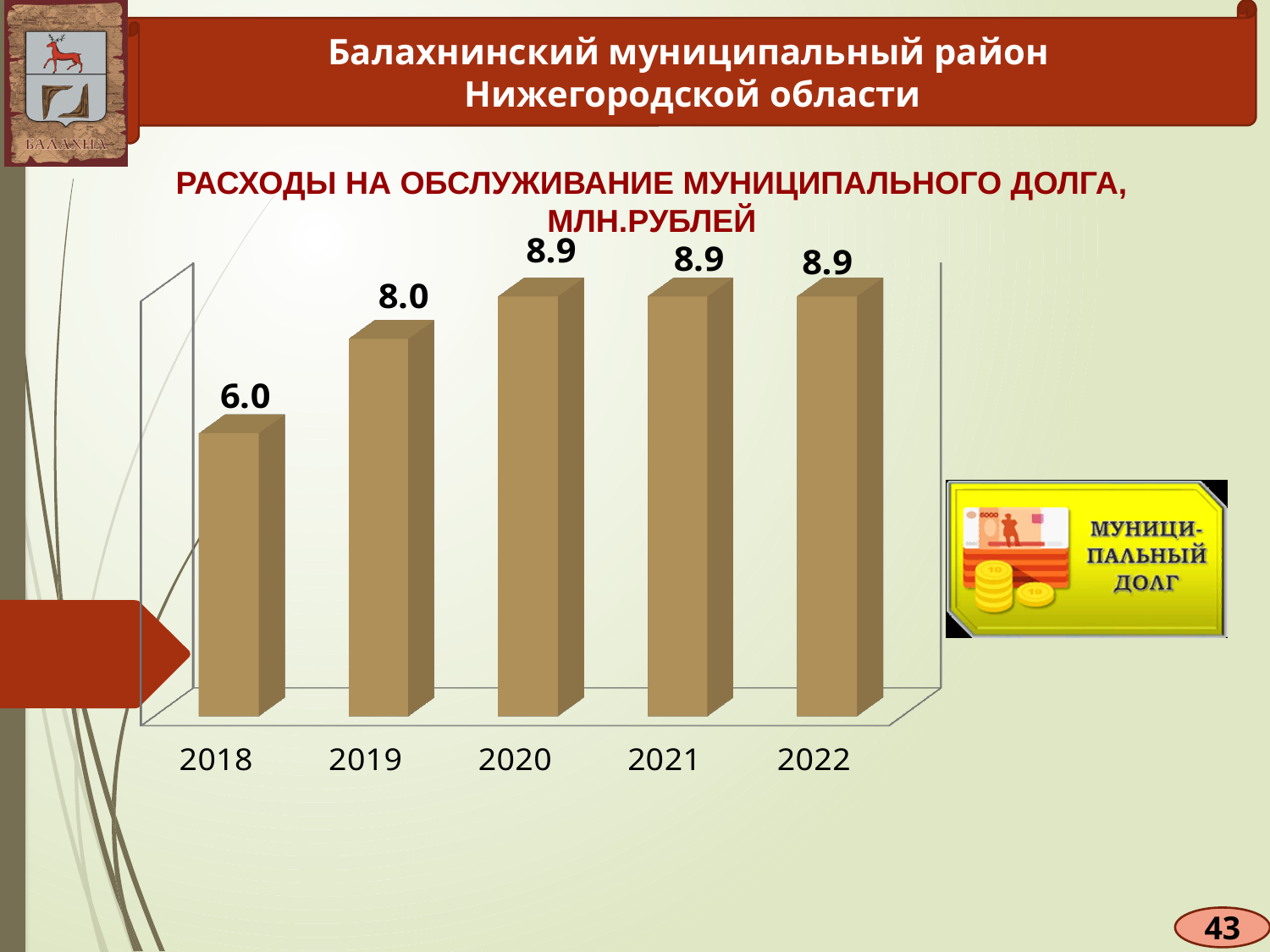
Which year has the lowest value? 2018 What is the value for 2019? 8.0 Which is larger, the value for 2019 or the value for 2021? 2021 What is the difference between the values for 2020 and 2019? 0.9 What kind of chart is shown on the slide? bar chart What unit is stated in the chart title? млн.рублей What is the value for 2018? 6.0 What is the value for 2022? 8.9 Do the values rise or fall from 2018 to 2020? rise How many years are shown on the chart? 5 What is the difference between the values for 2019 and 2018? 2.0 What is the value for 2020? 8.9